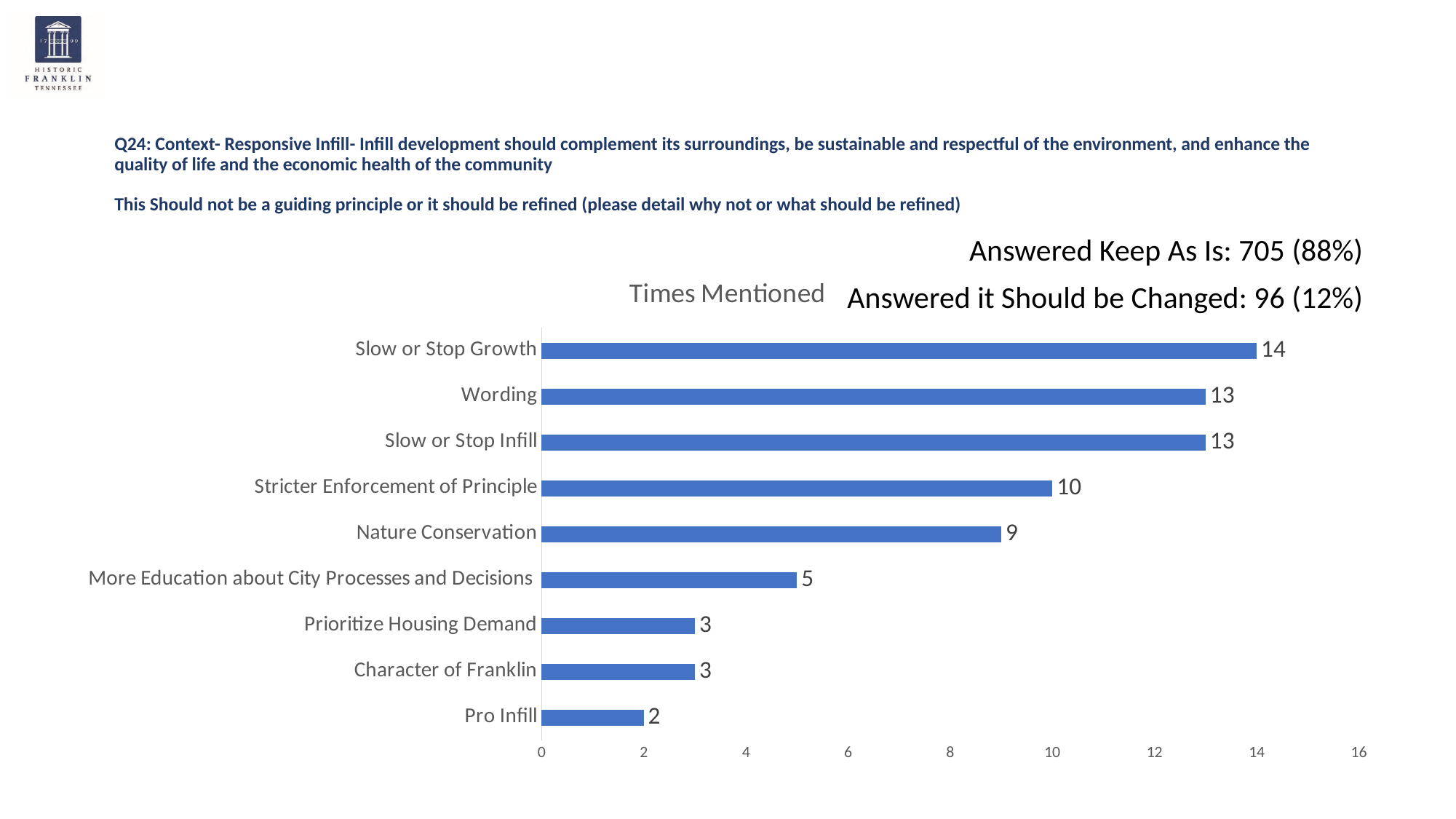
What is the title of the chart? Times Mentioned How many times was Nature Conservation mentioned? 9 Is the value for Stricter Enforcement of Principle greater or less than 8? greater What is the value for Slow or Stop Growth? 14 What is the difference between the values for Slow or Stop Infill and Pro Infill? 11 What is the difference between the values for Slow or Stop Growth and Stricter Enforcement of Principle? 4 What is the value for More Education about City Processes and Decisions? 5 Which category has the lowest number of times mentioned? Pro Infill What kind of chart is shown on the slide? Bar chart Which is larger, the value for Wording or the value for Nature Conservation? Wording Which category has the highest number of times mentioned? Slow or Stop Growth How many categories are shown in the chart? 9